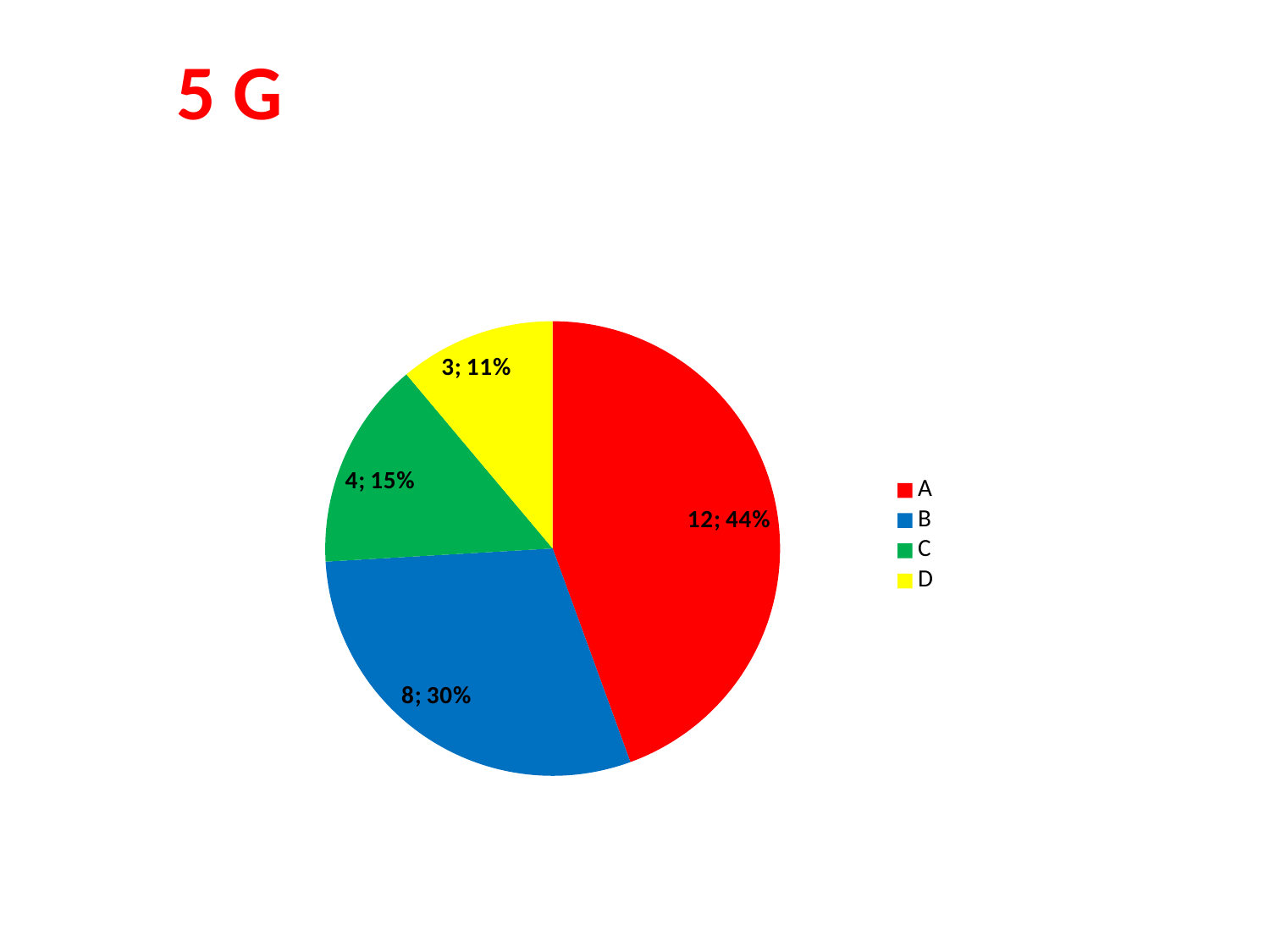
How many categories does the legend list? 4 What share of the pie does category B represent? 30% What is the value for category B? 8 What share of the pie does category C represent? 15% What is the value for category D? 3 What is the difference between the values for A and B? 4 Which is larger, the value for C or the value for D? C Which category has the smallest slice? D What is the value for category C? 4 What is the value for category A? 12 What kind of chart is shown on the slide? pie chart Which category has the largest slice? A